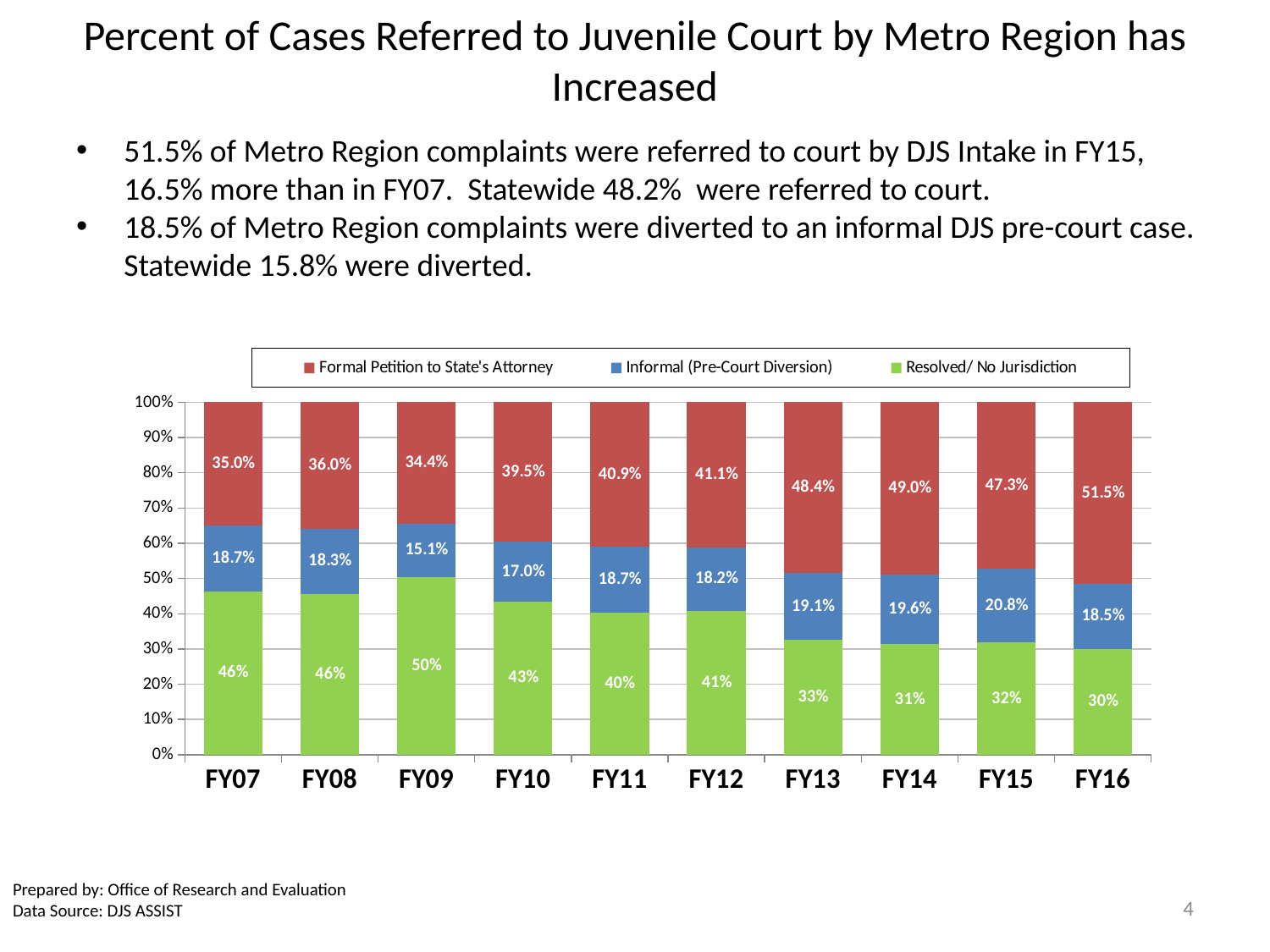
What is the value for Resolved/ No Jurisdiction in FY09? 50% In which fiscal year is the Formal Petition to State's Attorney share highest? FY16 What is the value for Formal Petition to State's Attorney in FY16? 51.5% In which fiscal year is the Resolved/ No Jurisdiction share lowest? FY16 Does the Resolved/ No Jurisdiction share generally rise or fall from FY07 to FY16? Fall How much higher is the Formal Petition to State's Attorney share in FY16 than in FY07? 16.5% In which fiscal year is the Informal (Pre-Court Diversion) share lowest? FY09 How many fiscal years are shown on the x axis? 10 Which is larger, the Resolved/ No Jurisdiction share in FY07 or in FY13? FY07 What kind of chart is shown on the slide? Stacked bar chart How many series does the legend list? 3 What is the value for Informal (Pre-Court Diversion) in FY15? 20.8%